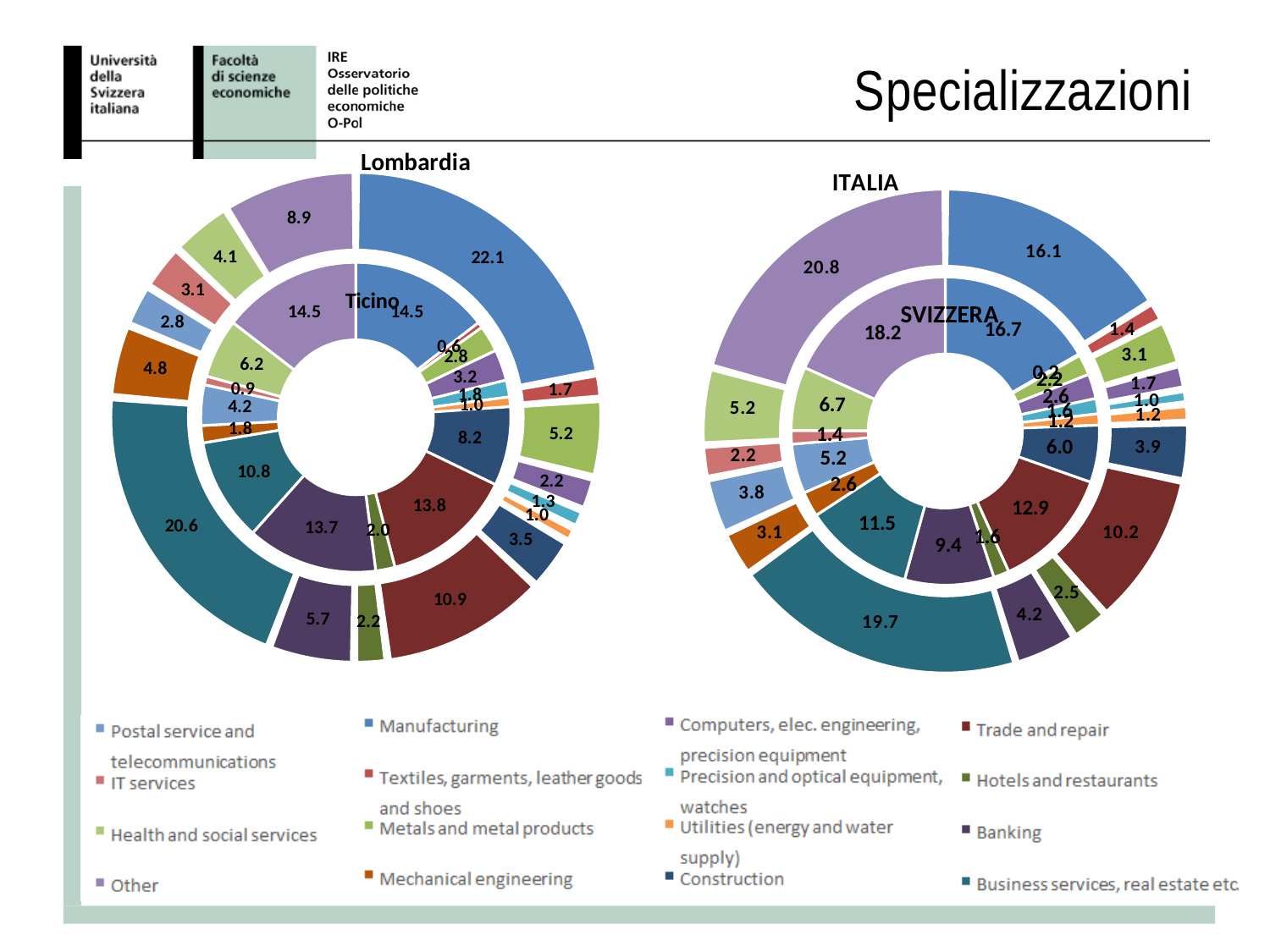
In the left doughnut chart, what is the value for Manufacturing in the outer Lombardia ring? 22.1 What is the title of the slide? Specializzazioni In the right doughnut chart, what is the value for Trade and repair in the inner SVIZZERA ring? 12.9 In the left doughnut chart, what is the difference between the Manufacturing value for Lombardia (22.1) and for Ticino (14.5)? 7.6 How many categories does the legend list? 16 In the left doughnut chart, what is the value for Construction in the inner Ticino ring? 8.2 In the right doughnut chart, what is the value for Other in the outer ITALIA ring? 20.8 What kind of chart is used on this slide? Doughnut chart In the left doughnut chart, is the Banking value larger for Ticino or for Lombardia? Ticino In the right doughnut chart, which category has the largest value in the outer ITALIA ring? Other In the left doughnut chart, which category has the largest value in the outer Lombardia ring? Manufacturing In the right doughnut chart, what is the value for Business services, real estate etc. in the outer ITALIA ring? 19.7